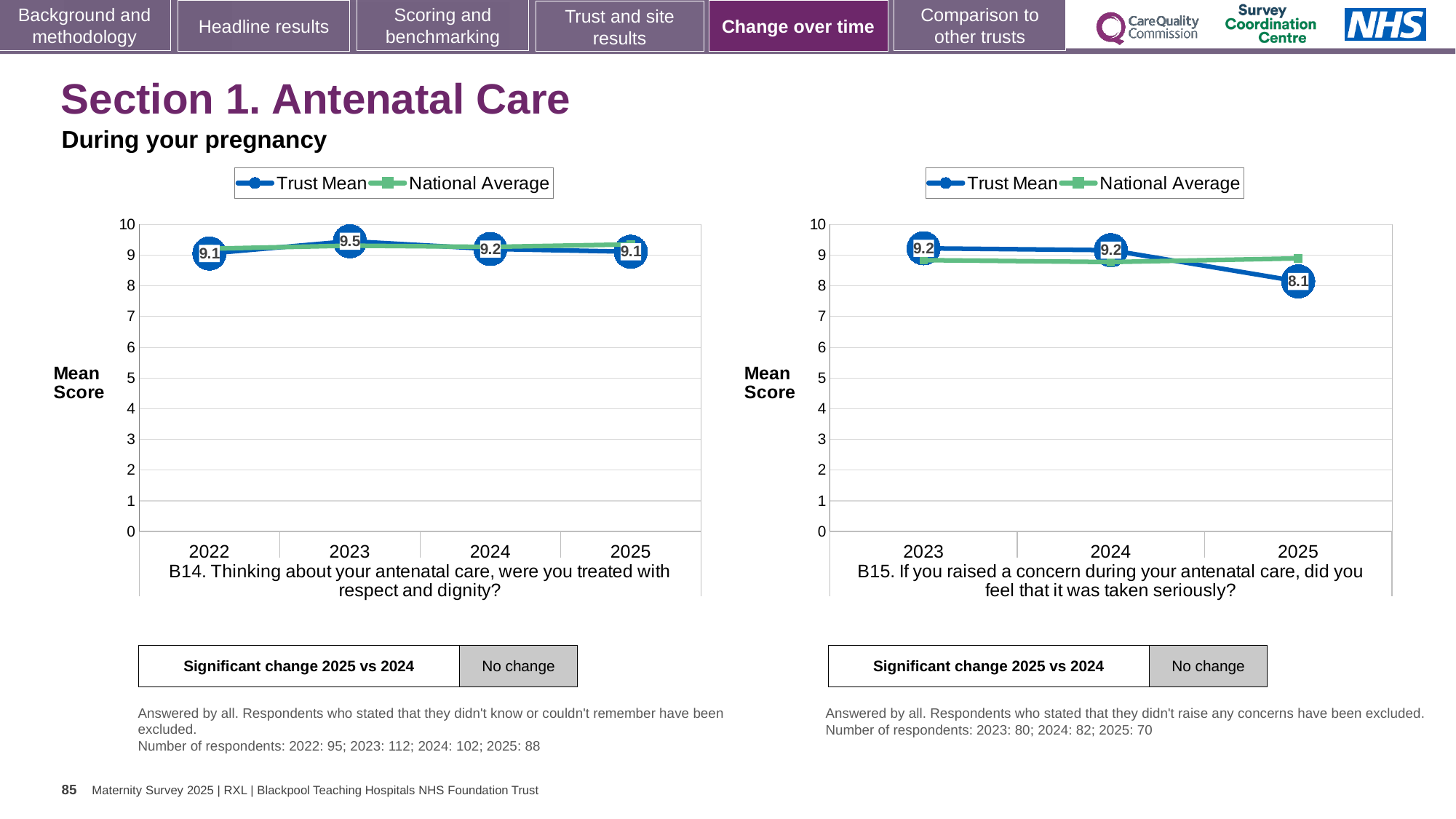
In the B15 chart (right), what is the Trust Mean for 2025? 8.1 In the B15 chart (right), what is the Trust Mean for 2023? 9.2 In the B15 chart (right), is the National Average for 2025 greater or less than 8? greater How many series does the legend of the B14 chart (left) list? 2 In the B14 chart (left), how many years are shown on the x axis? 4 In the B14 chart (left), what is the Trust Mean for 2023? 9.5 In the B14 chart (left), what is the difference between the Trust Mean in 2023 and in 2024? 0.3 In the B14 chart (left), what is the Trust Mean for 2025? 9.1 In the B15 chart (right), what is the difference between the Trust Mean in 2024 and in 2025? 1.1 In the B15 chart (right), which year has the lowest Trust Mean? 2025 In the B14 chart (left), which year has the highest Trust Mean? 2023 In the B15 chart (right), does the Trust Mean rise or fall from 2024 to 2025? fall